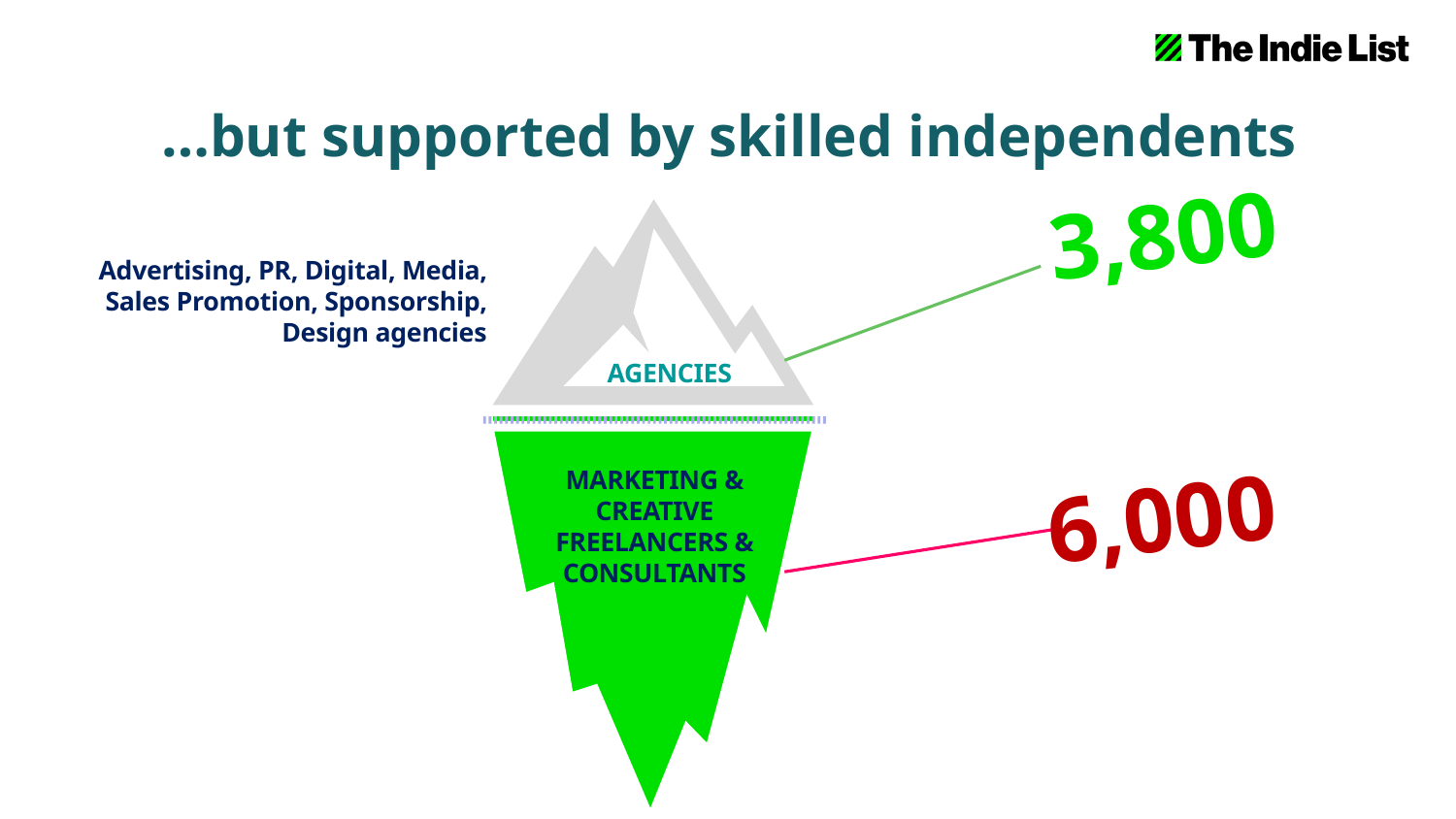
What is the title of the slide? ...but supported by skilled independents What is the difference between the value for Marketing & Creative Freelancers & Consultants and the value for Agencies? 2,200 Which group has the highest value on the slide? Marketing & Creative Freelancers & Consultants Which group has the lowest value on the slide? Agencies What is the combined total of the two values shown on the slide? 9,800 Which part of the iceberg is coloured green, the part above the waterline or the part below it? The part below the waterline What value is shown for Marketing & Creative Freelancers & Consultants? 6,000 What value is shown for Agencies? 3,800 How many groups have values shown on the slide? 2 Which group has the larger value, Agencies or Marketing & Creative Freelancers & Consultants? Marketing & Creative Freelancers & Consultants